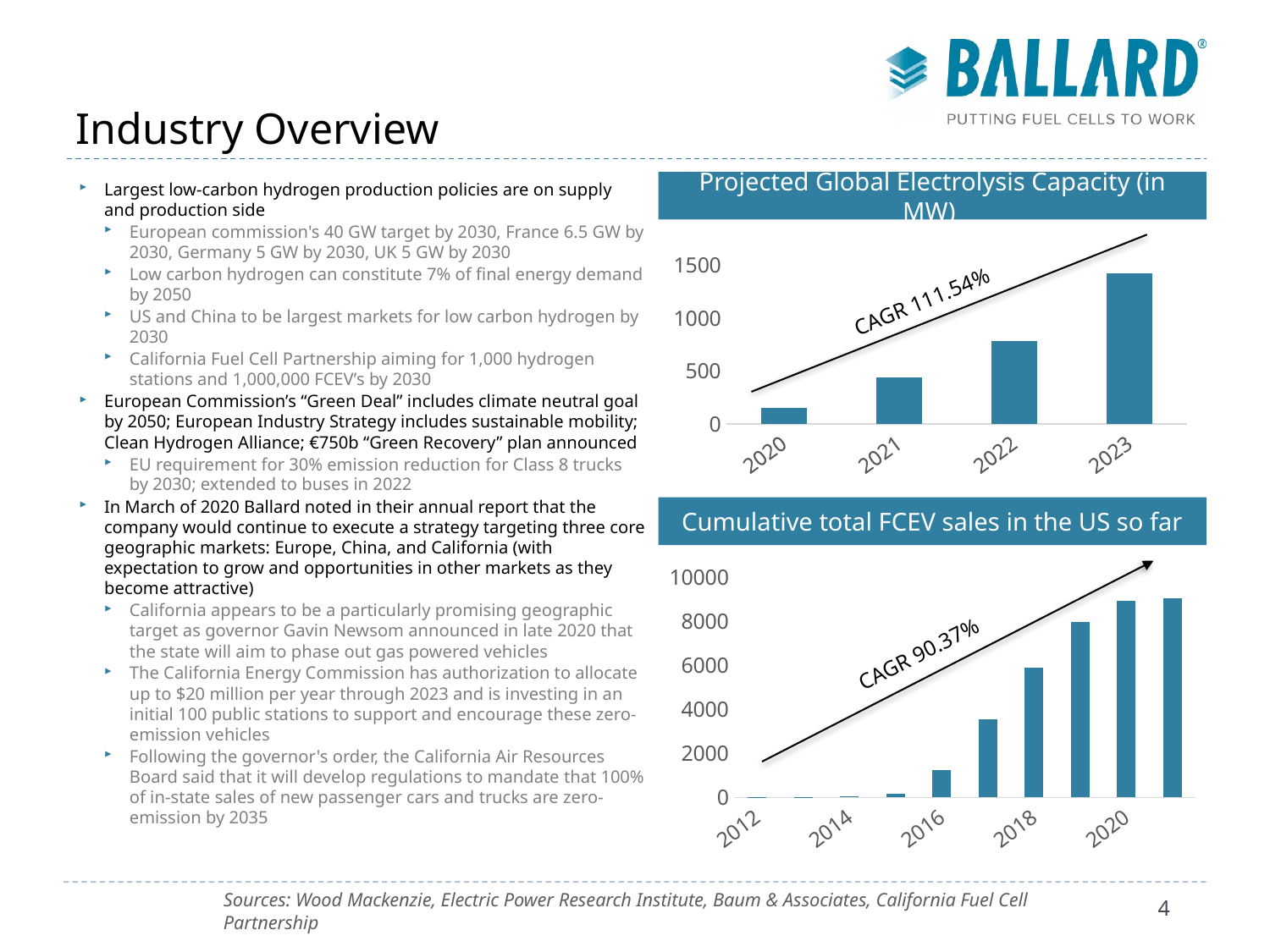
In the 'Projected Global Electrolysis Capacity (in MW)' chart, how many years are shown on the x axis? 4 In the 'Projected Global Electrolysis Capacity (in MW)' chart, is the value for 2022 greater or less than 1000? less In the 'Cumulative total FCEV sales in the US so far' chart, is the value for 2018 greater or less than 4000? greater What CAGR is annotated on the 'Cumulative total FCEV sales in the US so far' chart? CAGR 90.37% What CAGR is annotated on the 'Projected Global Electrolysis Capacity (in MW)' chart? CAGR 111.54% In the 'Projected Global Electrolysis Capacity (in MW)' chart, do the values rise or fall from 2020 to 2023? rise In the 'Projected Global Electrolysis Capacity (in MW)' chart, is the value for 2023 greater or less than 1000? greater In the 'Cumulative total FCEV sales in the US so far' chart, which is larger, the value for 2018 or the value for 2016? 2018 In the 'Projected Global Electrolysis Capacity (in MW)' chart, which year has the highest projected capacity? 2023 What type of chart is the 'Projected Global Electrolysis Capacity (in MW)' chart? bar chart In the 'Projected Global Electrolysis Capacity (in MW)' chart, which year has the lowest capacity? 2020